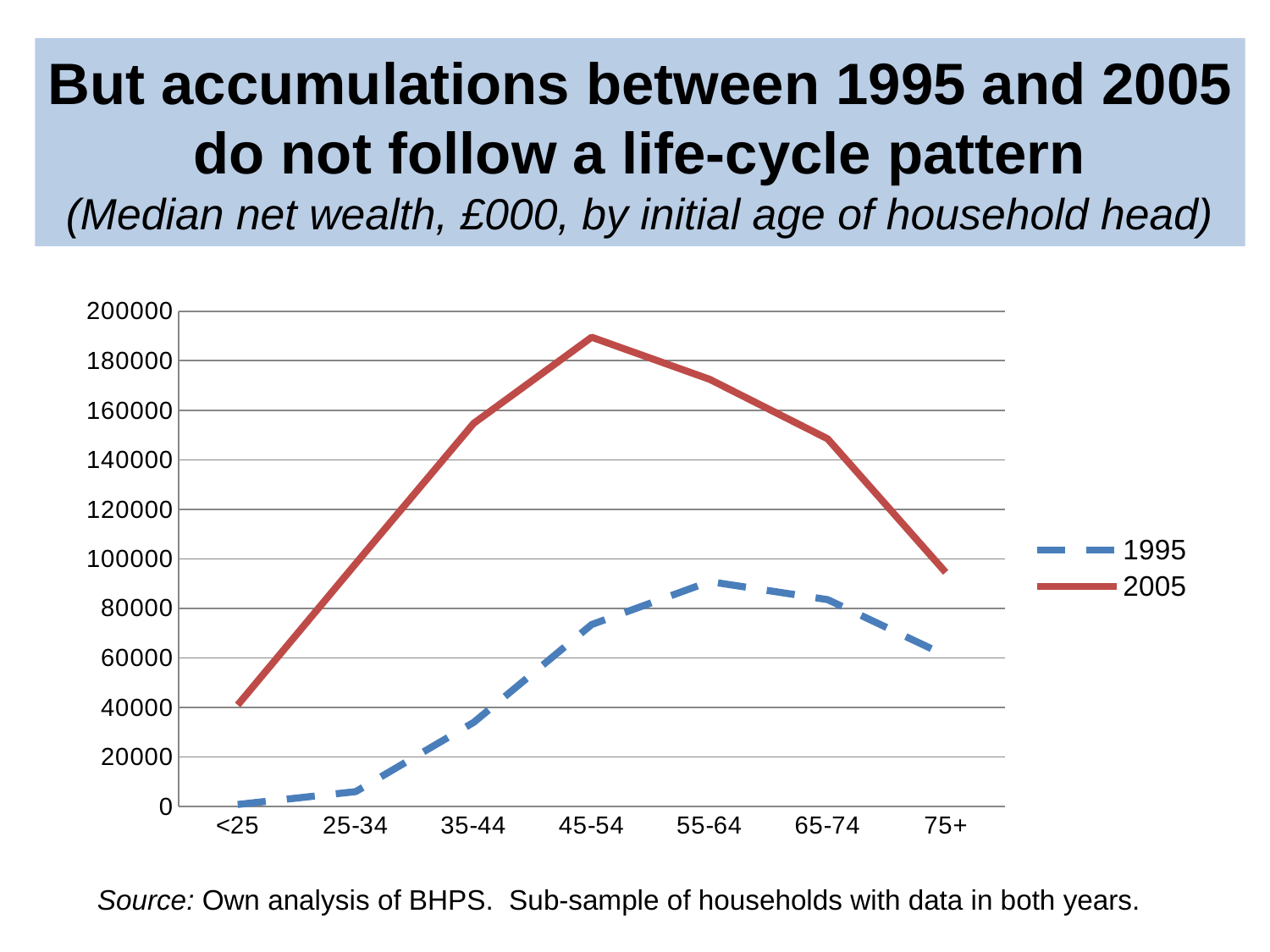
Which age group has the highest median net wealth for the 1995 series? 55-64 What kind of chart is shown on the slide? line chart Which age group has the lowest median net wealth for the 2005 series? <25 Which age group has the highest median net wealth for the 2005 series? 45-54 How many age categories are shown on the x axis? 7 For the 45-54 age group, which series has the larger value, 1995 or 2005? 2005 Which age group has the lowest median net wealth for the 1995 series? <25 Does the 2005 series rise or fall from the 45-54 age group to the 75+ age group? fall Is the 2005 value for the 45-54 age group greater or less than 180000? greater How many series does the legend list? 2 Which series is drawn with a dashed line? 1995 Is the 1995 value for the 35-44 age group greater or less than 40000? less